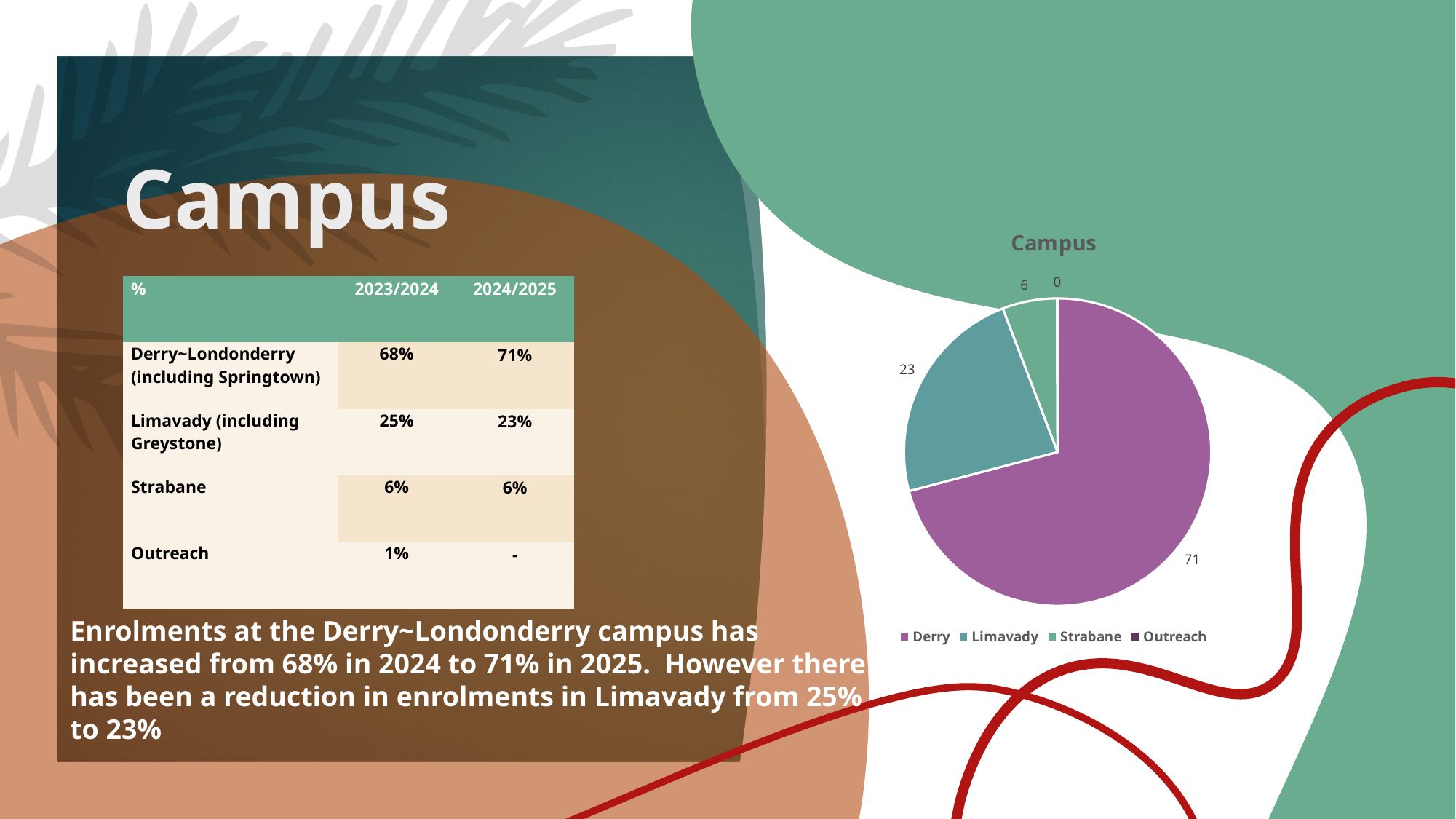
Which is larger in the pie chart, Limavady or Strabane? Limavady What is the value for Strabane in the pie chart? 6 How many categories does the legend of the pie chart list? 4 Which category has the smallest value in the pie chart? Outreach What is the value for Limavady in the pie chart? 23 Which category has the largest slice in the pie chart? Derry What is the difference between the values for Derry and Limavady in the pie chart? 48 What is the difference between the values for Limavady and Strabane in the pie chart? 17 What is the title of the chart? Campus What type of chart is shown on the slide? pie chart What is the value for Derry in the pie chart? 71 What is the value for Outreach in the pie chart? 0